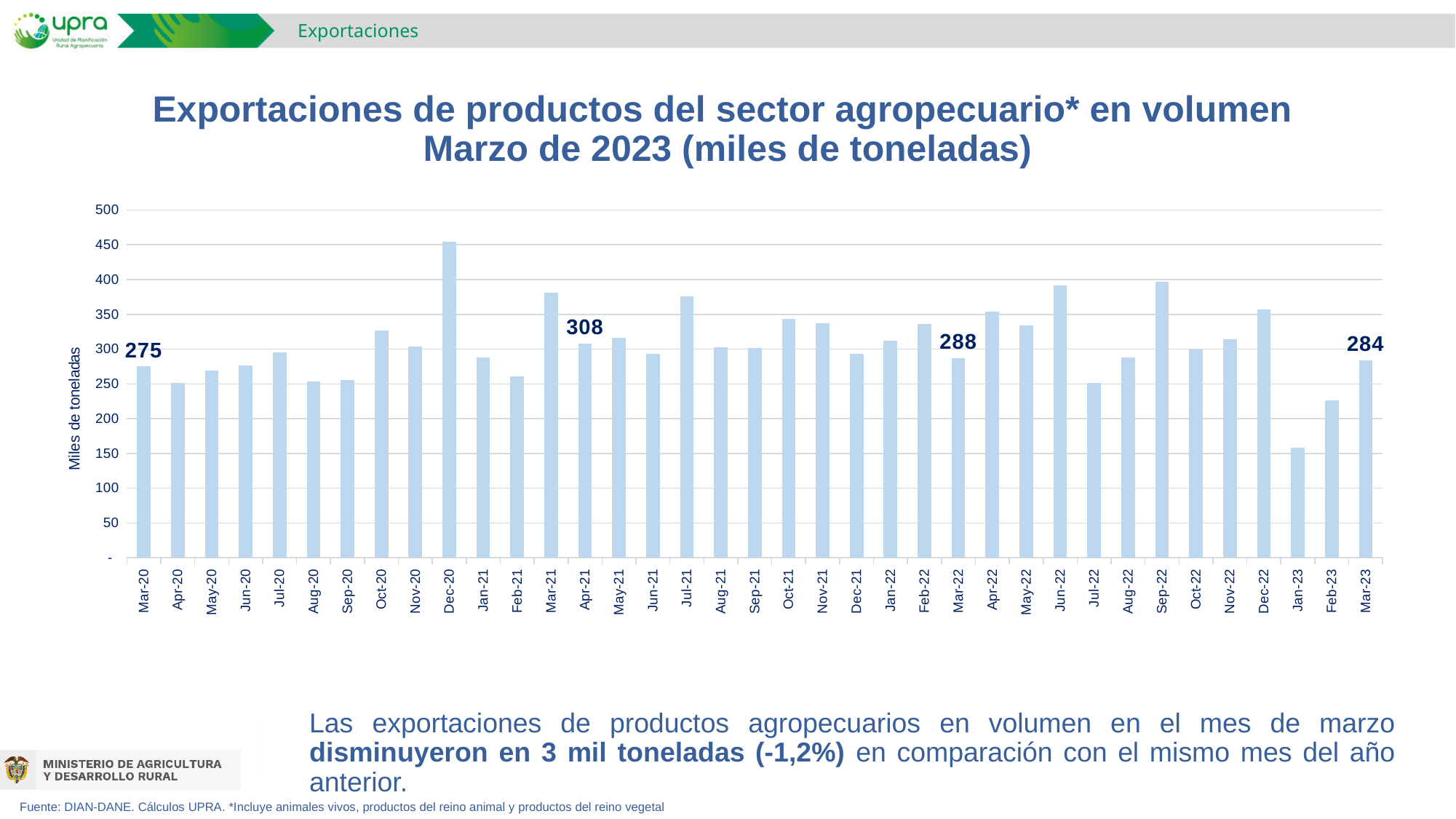
Which month has the lowest value? Jan-23 Is the value for Jan-23 greater or less than 200? less What kind of chart is shown? bar chart Which is larger, the value for Mar-21 or the value for Mar-22? Mar-21 What is the value for Mar-20? 275 How many months are plotted on the chart? 37 What is the value for Mar-23? 284 Which month has the highest value? Dec-20 Is the value for Dec-20 greater or less than 400? greater What is the value for Mar-22? 288